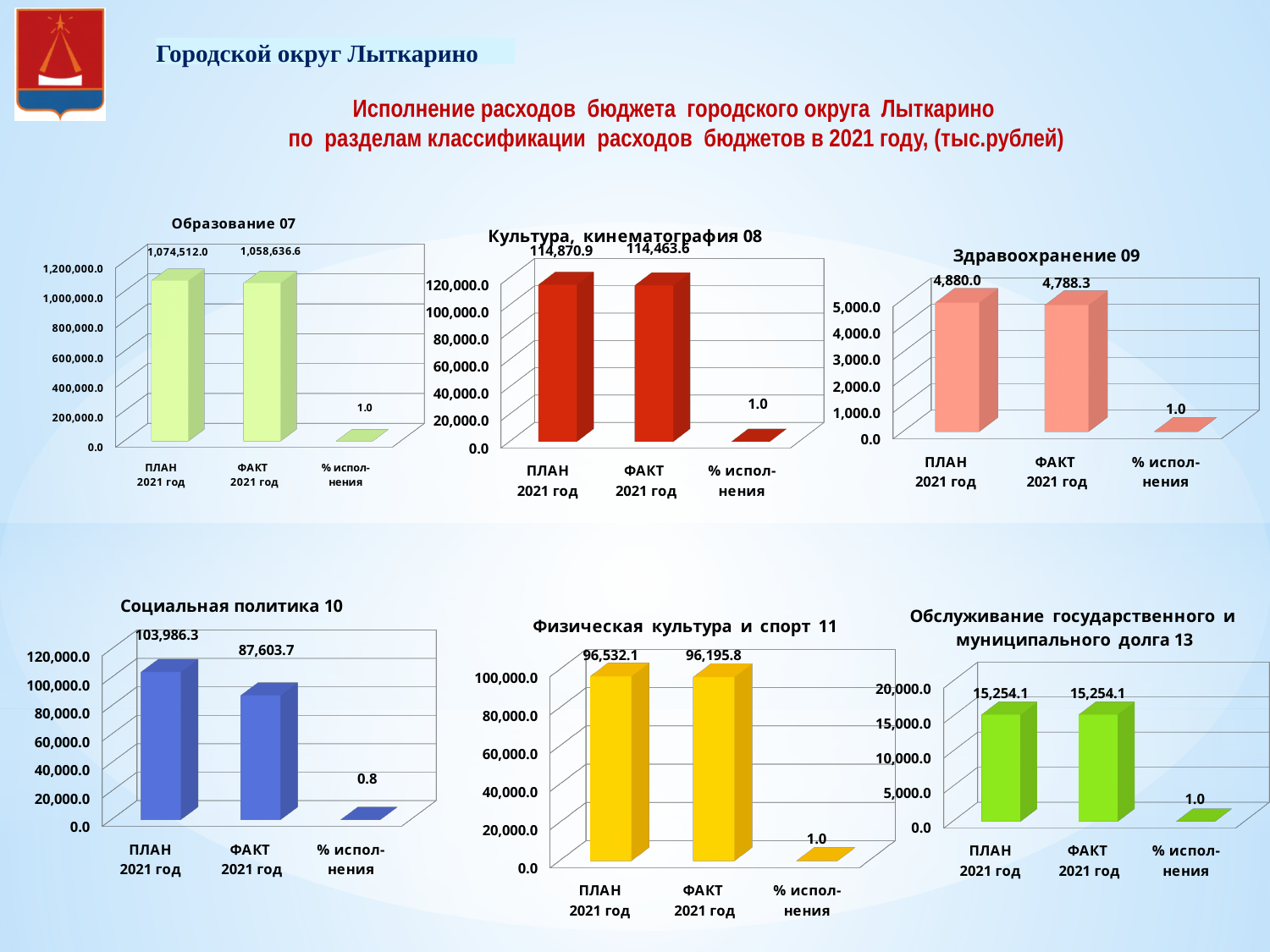
How many bars are plotted in the 'Культура, кинематография 08' chart? 3 In the 'Здравоохранение 09' chart, what is the value for ПЛАН 2021 год? 4,880.0 In the 'Социальная политика 10' chart, which is larger, ПЛАН 2021 год or ФАКТ 2021 год? ПЛАН 2021 год In the 'Образование 07' chart, which category has the highest value? ПЛАН 2021 год In the 'Социальная политика 10' chart, what is the value for % исполнения? 0.8 In the 'Культура, кинематография 08' chart, what is the value for ФАКТ 2021 год? 114,463.6 In the 'Физическая культура и спорт 11' chart, is the value for ФАКТ 2021 год greater or less than 80,000.0? greater In the 'Образование 07' chart, what is the value for ПЛАН 2021 год? 1,074,512.0 What kind of chart is 'Физическая культура и спорт 11'? bar chart In the 'Здравоохранение 09' chart, what is the difference between ПЛАН 2021 год and ФАКТ 2021 год? 91.7 In the 'Обслуживание государственного и муниципального долга 13' chart, what is the value for ФАКТ 2021 год? 15,254.1 In the 'Социальная политика 10' chart, what is the difference between ПЛАН 2021 год and ФАКТ 2021 год? 16,382.6